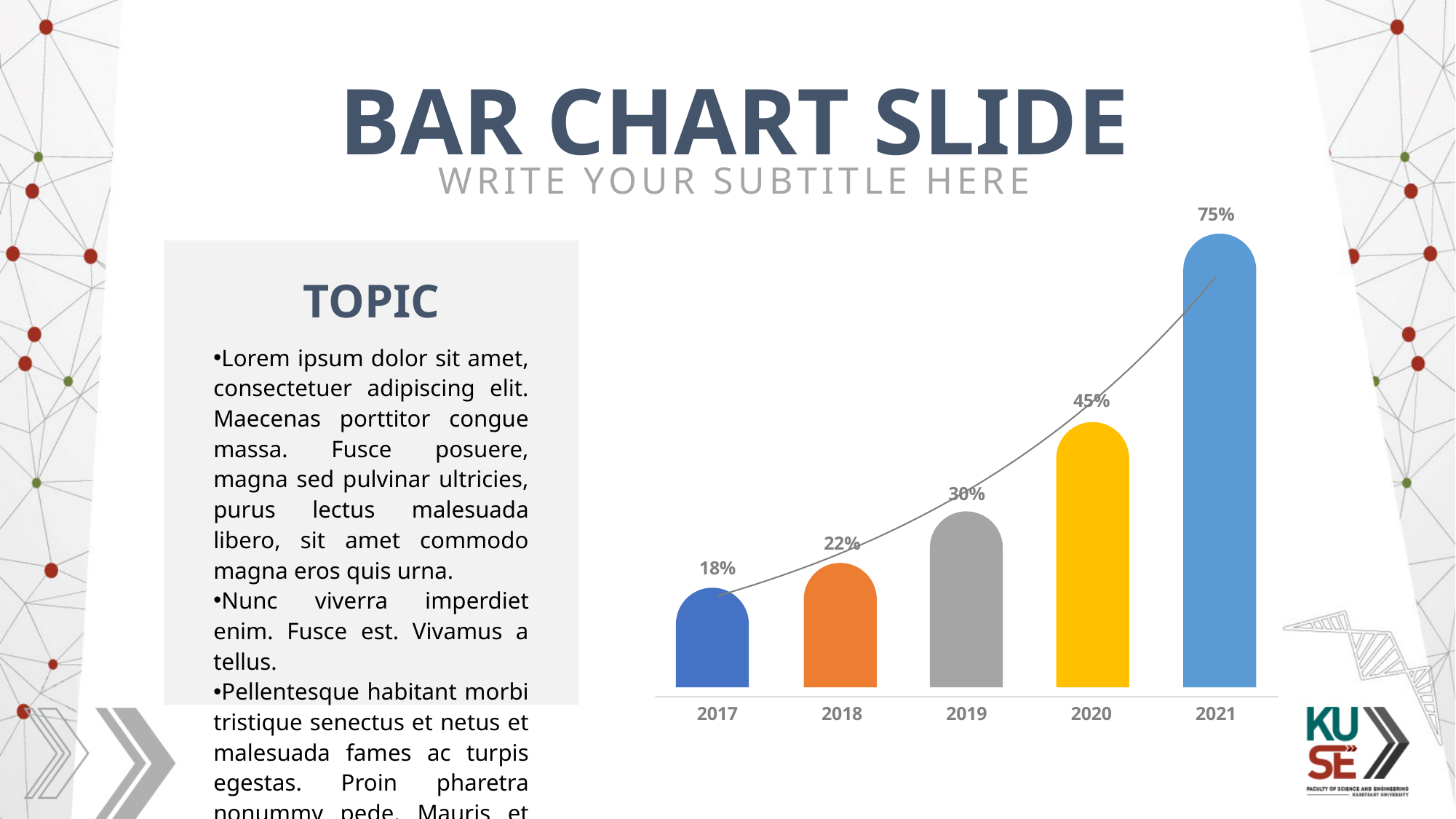
Which year has the lowest value? 2017 How many years are shown on the x axis? 5 Which year has the highest value? 2021 What kind of chart is shown on the slide? bar chart What is the difference between the values for 2021 and 2020? 30% Which is larger, the value for 2019 or the value for 2020? 2020 What colour is the bar for 2020? yellow What is the value for 2021? 75% What is the value for 2017? 18% What is the value for 2019? 30% Do the values rise or fall from 2017 to 2021? rise What is the difference between the values for 2018 and 2017? 4%